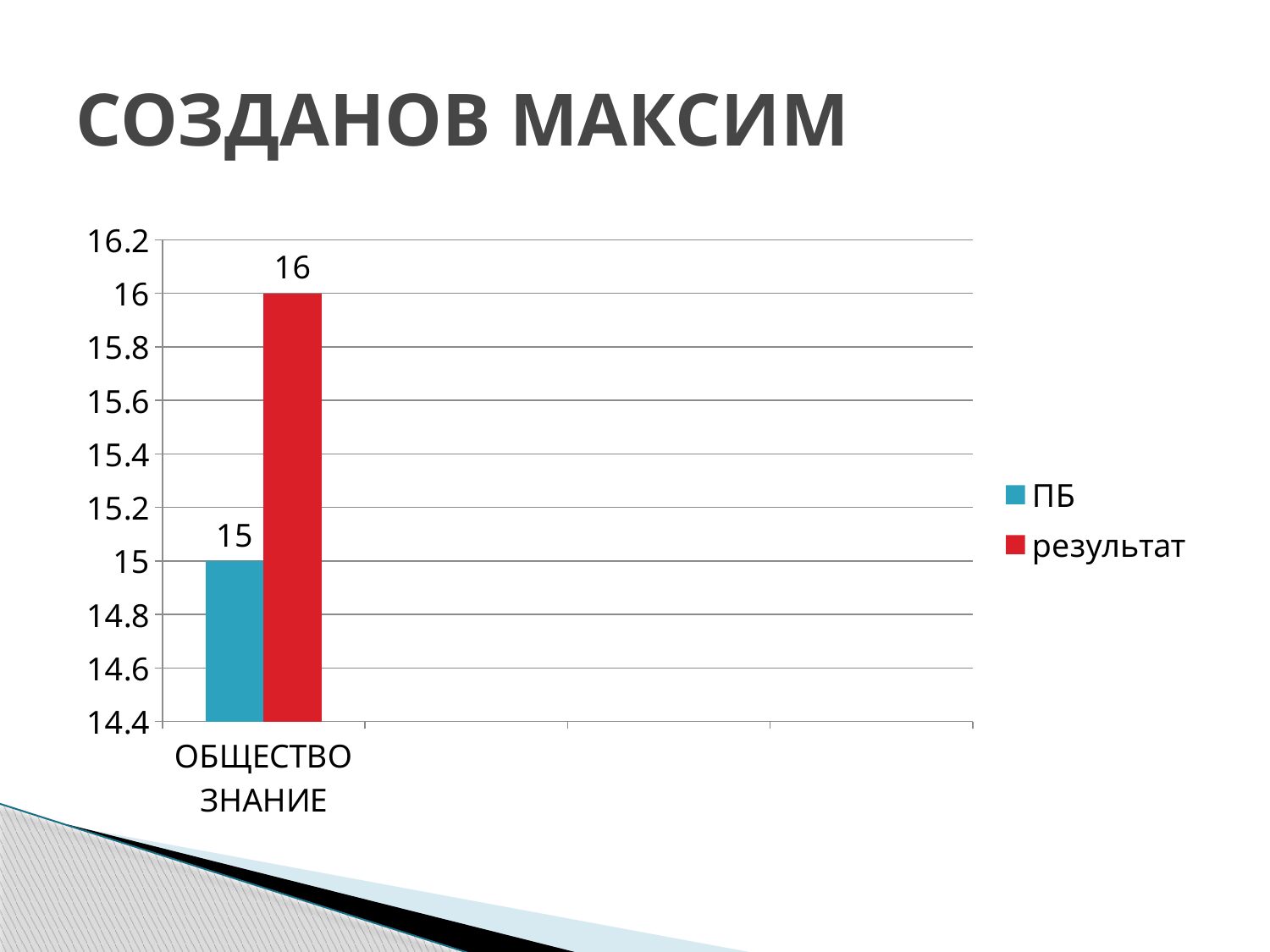
What is the difference between результат and ПБ for ОБЩЕСТВОЗНАНИЕ? 1 Is the value of результат for ОБЩЕСТВОЗНАНИЕ greater or less than 15.6? greater What kind of chart is shown on the slide? bar chart Is the value of ПБ for ОБЩЕСТВОЗНАНИЕ greater or less than 15.4? less Which series has the higher value for ОБЩЕСТВОЗНАНИЕ, ПБ or результат? результат What is the value of результат for ОБЩЕСТВОЗНАНИЕ? 16 How many series does the legend list? 2 What colour is the bar for the результат series? red What is the value of ПБ for ОБЩЕСТВОЗНАНИЕ? 15 What is the title of the slide? СОЗДАНОВ МАКСИМ How many categories are shown on the x axis? 1 What is the highest value shown on the y axis? 16.2